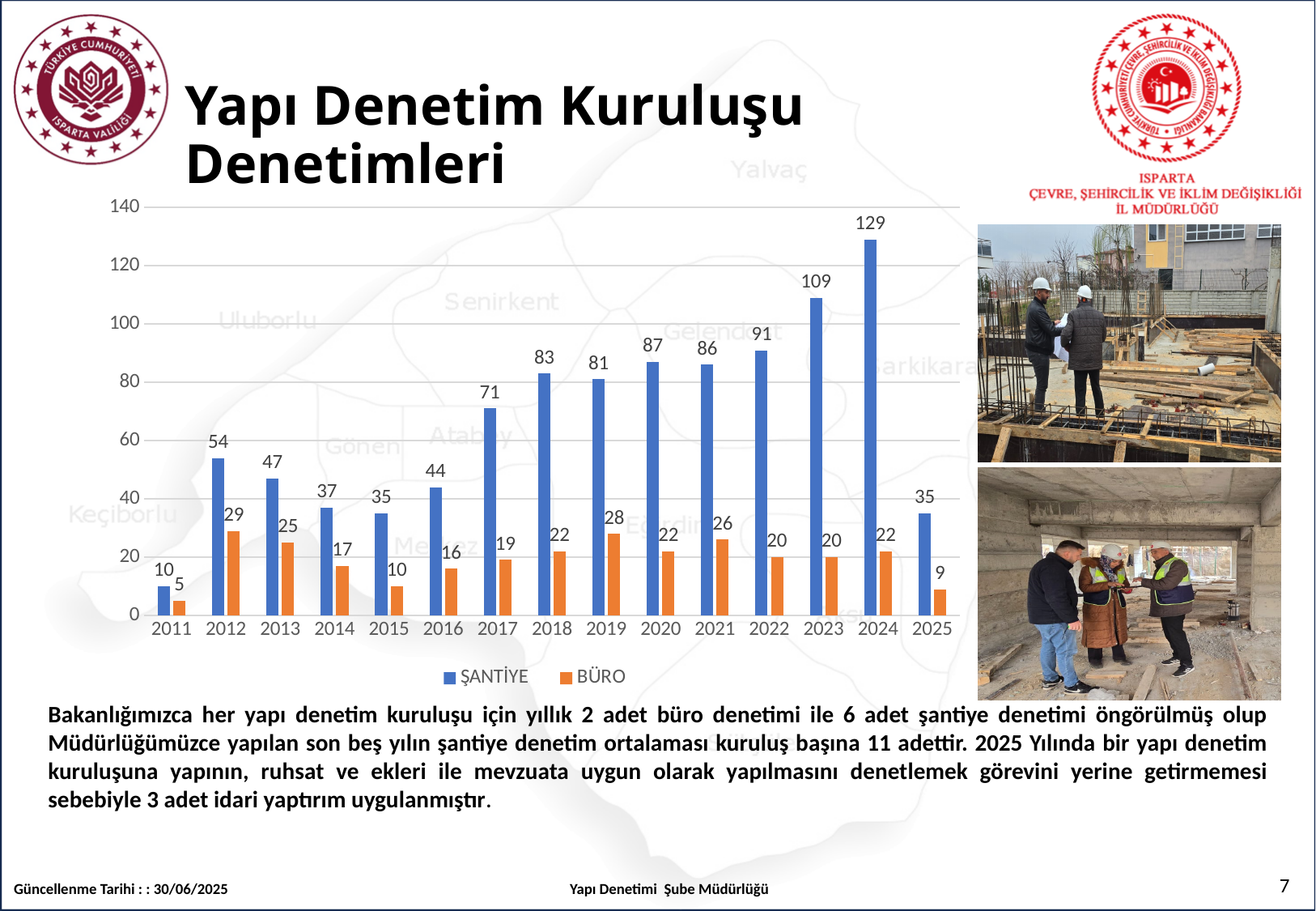
Which is larger, the BÜRO value for 2012 or the BÜRO value for 2021? 2012 How many series does the legend list? 2 What colour are the BÜRO bars? orange What is the BÜRO value for 2019? 28 How many years are shown on the x axis? 15 Which year has the highest ŞANTİYE value? 2024 What is the ŞANTİYE value for 2024? 129 What kind of chart is shown on the slide? bar chart What is the ŞANTİYE value for 2017? 71 Do the ŞANTİYE values rise or fall from 2020 to 2024? rise What is the difference between the ŞANTİYE values for 2024 and 2023? 20 Which year has the lowest BÜRO value? 2011